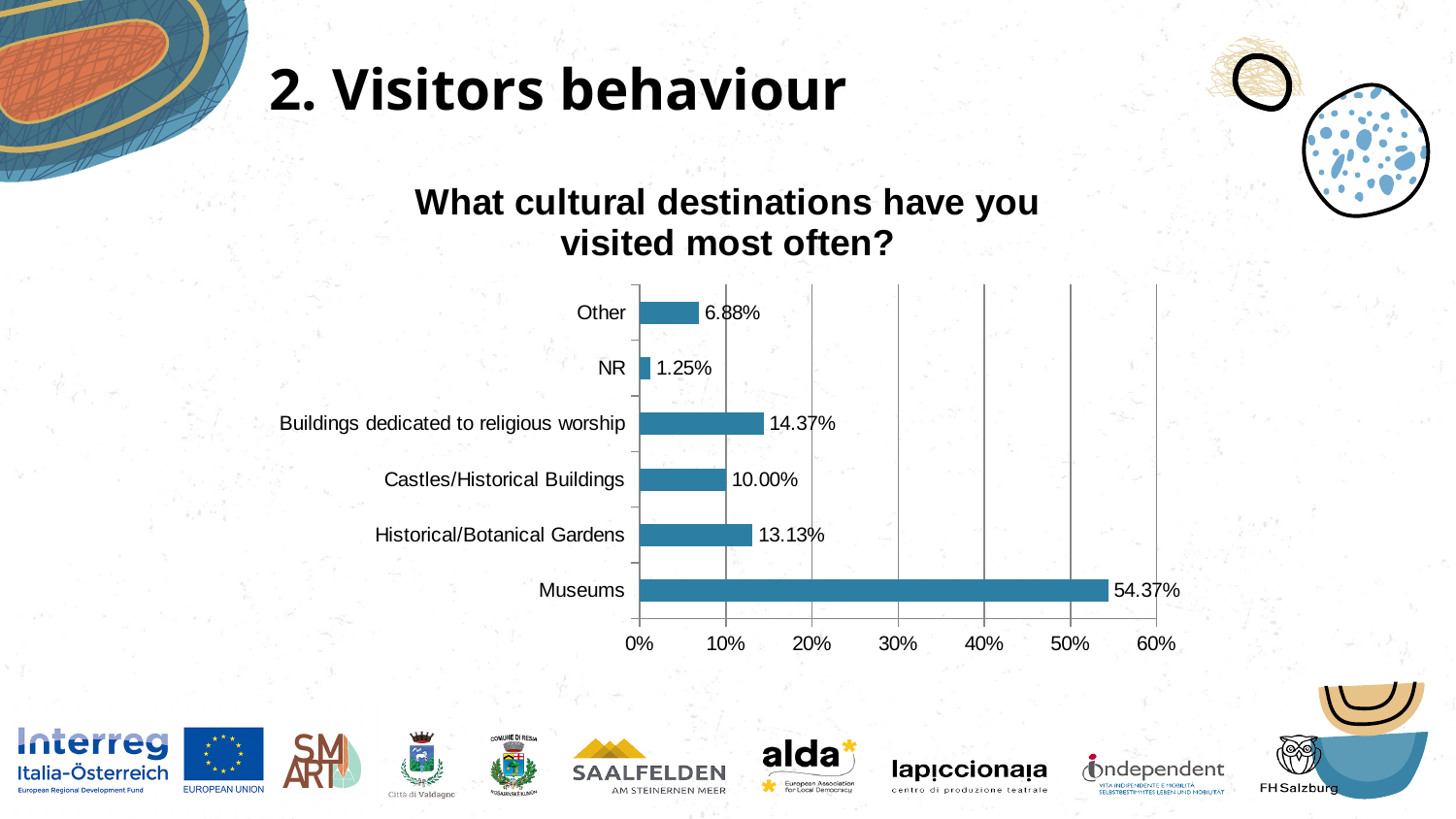
What is the value for NR? 1.25% What percentage of respondents visited Museums most often? 54.37% What is the value for Historical/Botanical Gardens? 13.13% What is the value for Buildings dedicated to religious worship? 14.37% What question does the chart title ask? What cultural destinations have you visited most often? What kind of chart is shown on the slide? bar chart Is the value for Other greater or less than 10%? less Which category has the highest value? Museums Which category has the lowest value? NR What is the difference between the values for Museums and Castles/Historical Buildings? 44.37% How many categories are shown in the chart? 6 Which is larger: the value for Historical/Botanical Gardens or the value for Castles/Historical Buildings? Historical/Botanical Gardens